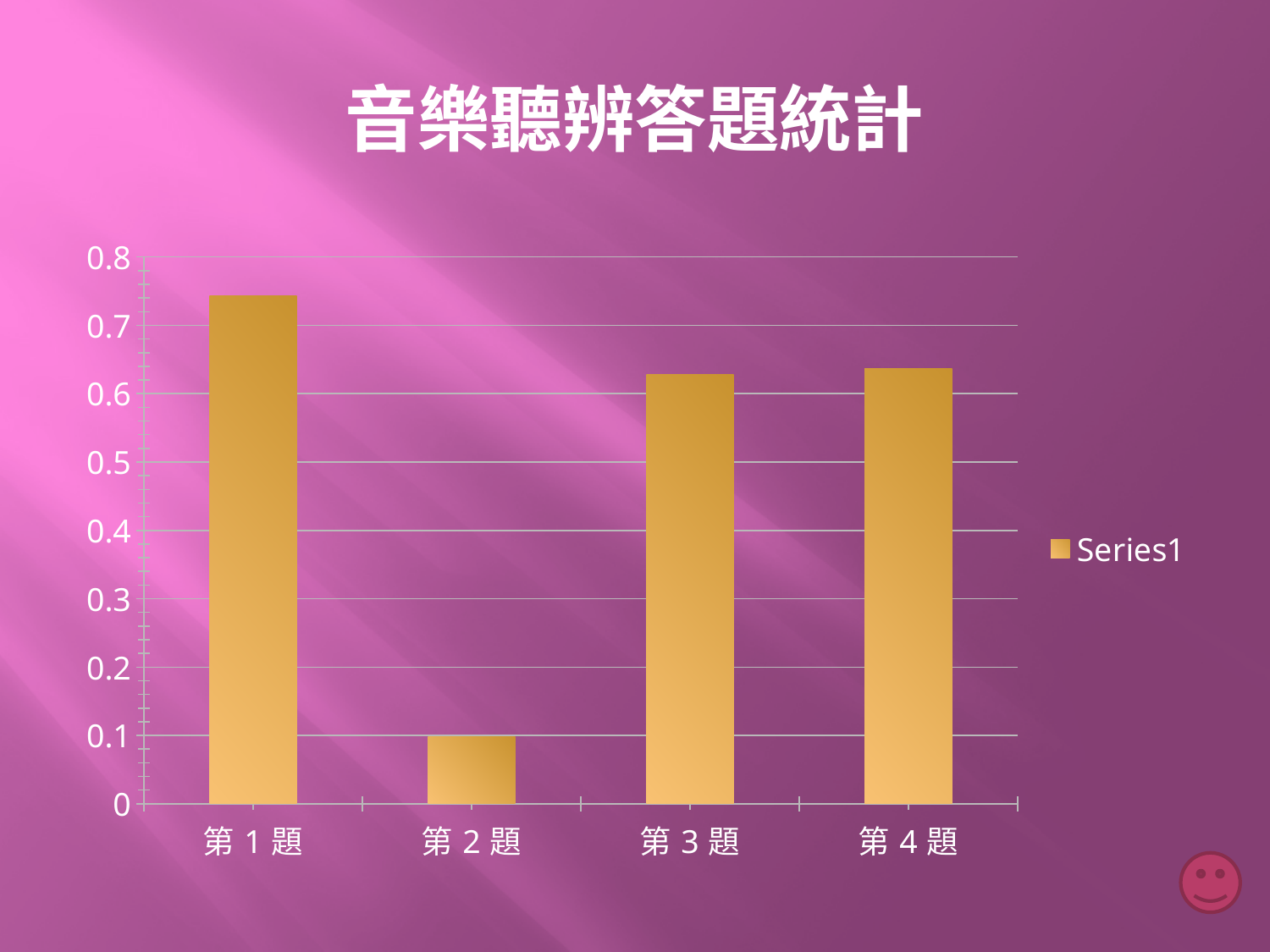
How many categories are shown on the x axis? 4 Is the value for 第 3 題 greater or less than 0.6? greater Which category has the lowest value? 第 2 題 How many series does the legend list? 1 What type of chart is shown on the slide? bar chart Which category has the highest value? 第 1 題 What is the name of the series shown in the legend? Series1 Is the value for 第 1 題 greater or less than 0.7? greater Which is larger, the value for 第 1 題 or the value for 第 3 題? 第 1 題 What is the title of the chart? 音樂聽辨答題統計 Is the value for 第 4 題 greater or less than 0.7? less